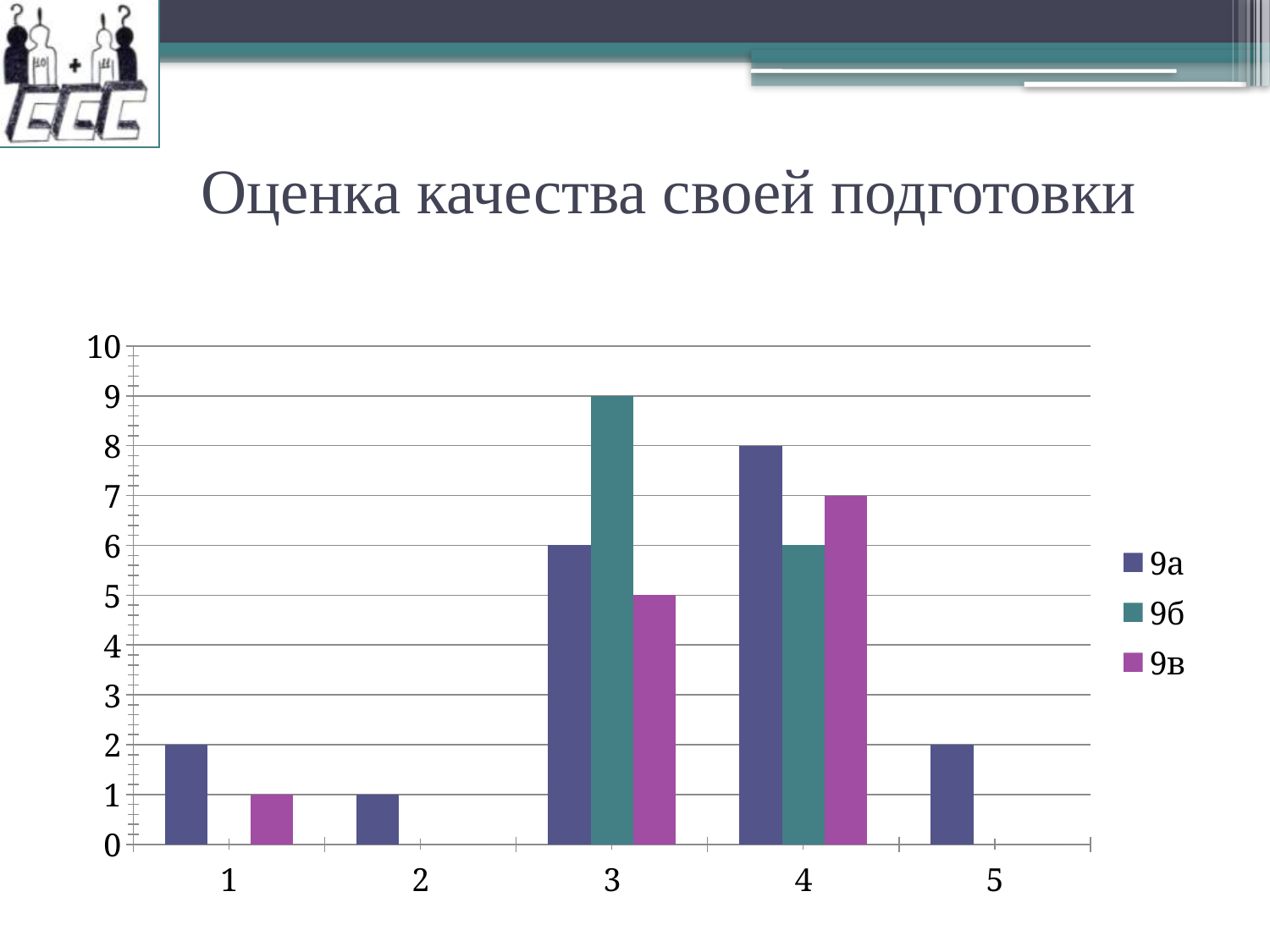
What is the value for series 9б at category 3? 9 What is the value for series 9в at category 4? 7 How many series does the legend list? 3 What kind of chart is shown on the slide? bar chart What is the title of the chart on the slide? Оценка качества своей подготовки What is the value for series 9а at category 5? 2 How many categories are shown on the x axis? 5 What is the difference between the 9б value and the 9в value at category 3? 4 At which category does series 9а reach its highest value? 4 At category 4, which series has the larger value, 9а or 9б? 9а What is the value for series 9а at category 4? 8 At which category does series 9в have its lowest value? 2 and 5